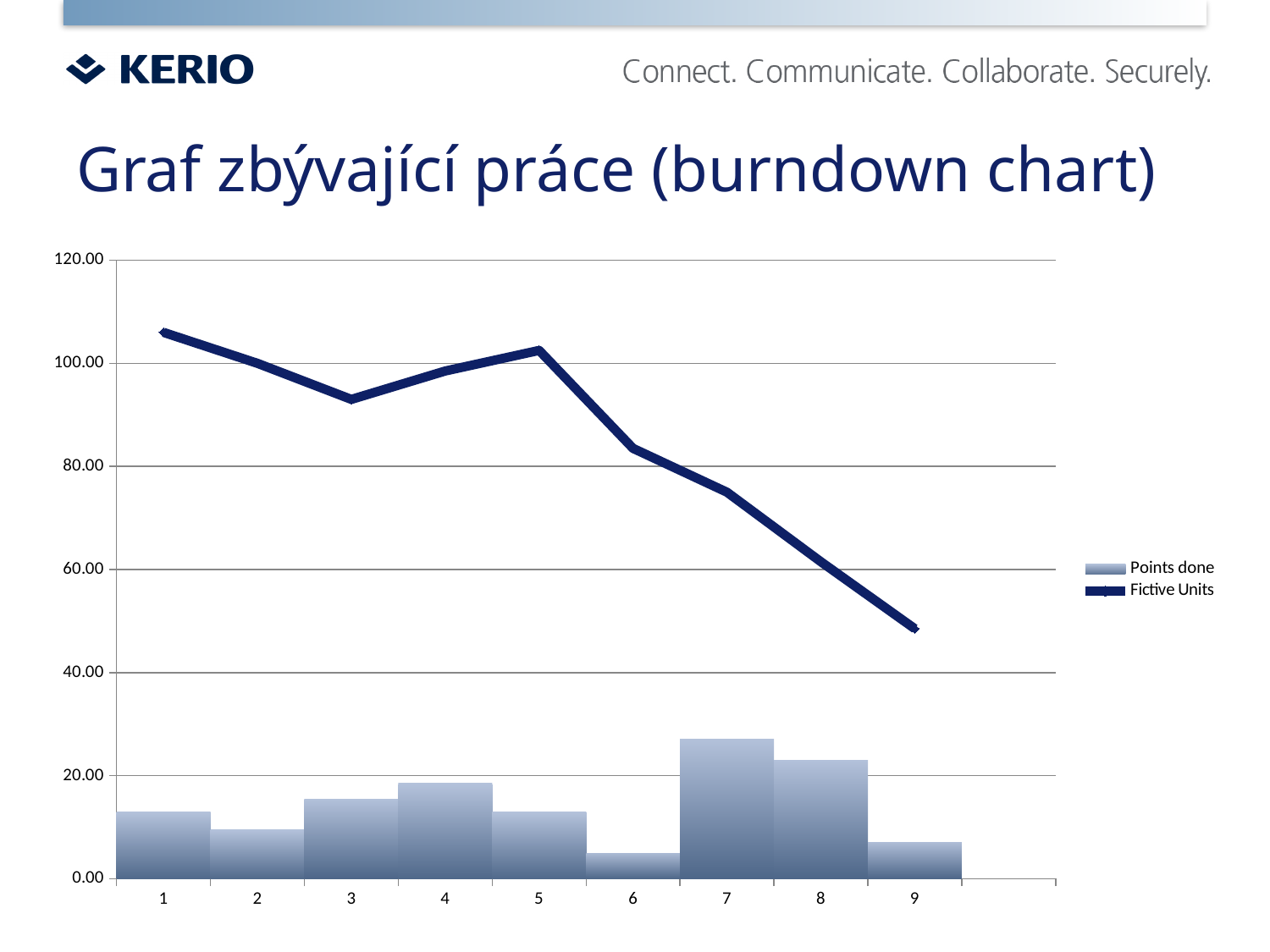
Which category has the highest Points done bar? 7 Does the Fictive Units line rise or fall overall from category 1 to category 9? fall Is the Fictive Units value for category 1 greater or less than 100? greater Is the Points done value for category 7 greater or less than 20? greater What kind of chart is this? A combination bar and line chart Which is larger, the Points done value for category 4 or for category 5? category 4 Is the Fictive Units value for category 9 greater or less than 60? less Which category has the lowest Points done bar? 6 How many series does the legend list? 2 Which category has the lowest Fictive Units value? 9 What are the two series named in the legend? Points done and Fictive Units How many categories are shown on the x axis? 9